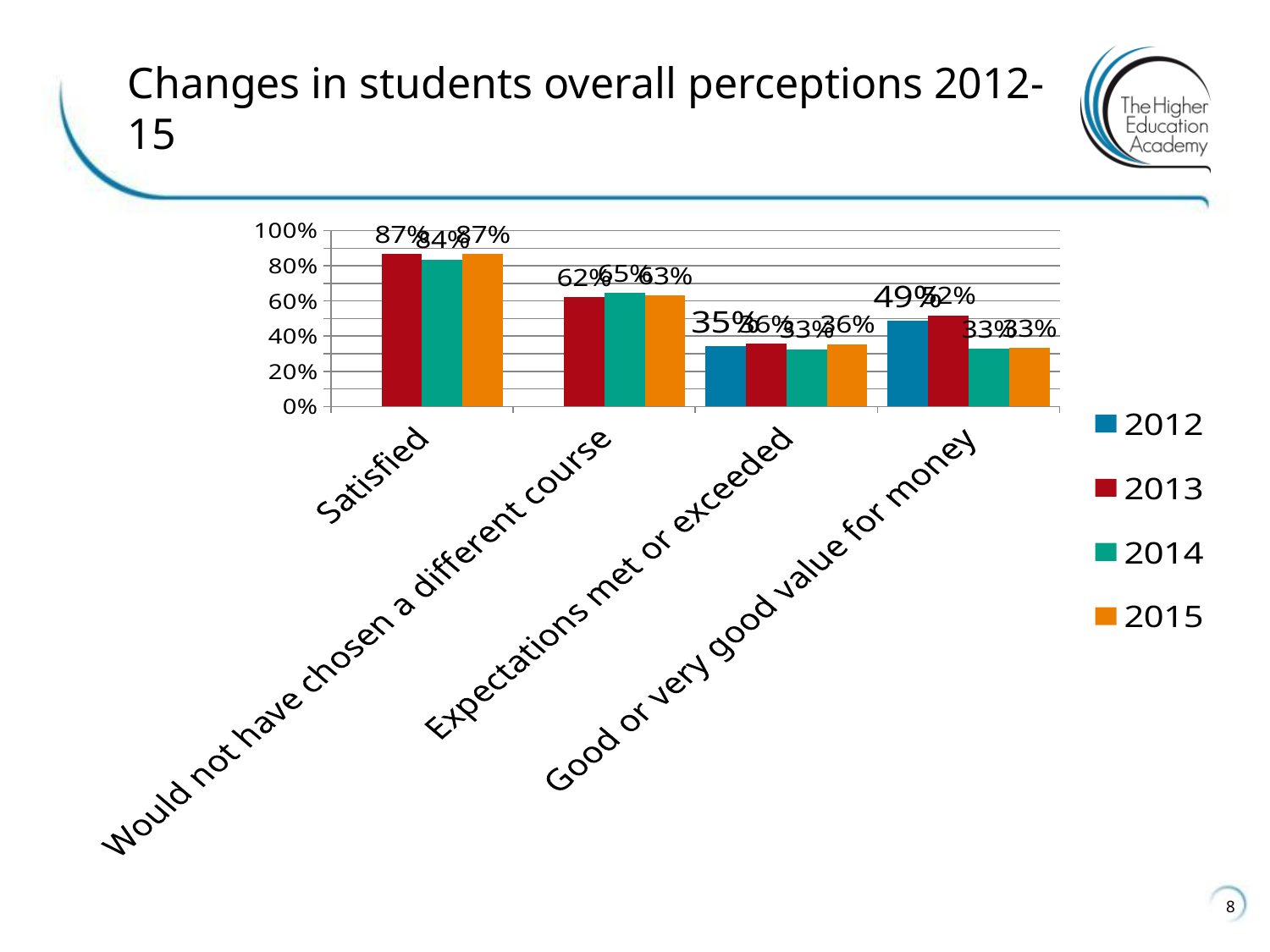
What is the value for 2014 in the 'Would not have chosen a different course' category? 65% In the 'Would not have chosen a different course' category, which is larger: the 2014 value or the 2015 value? 2014 What is the value for 2015 in the 'Good or very good value for money' category? 33% What is the value for 2014 in the Satisfied category? 84% What is the value for 2012 in the 'Expectations met or exceeded' category? 35% Which category has the lowest value for 2012? Expectations met or exceeded Is the 2013 value for 'Good or very good value for money' greater or less than 40%? greater How many series does the legend list? 4 What is the value for 2012 in the 'Good or very good value for money' category? 49% Which category has the highest value for 2015? Satisfied What is the difference between the 2013 and 2014 values in the Satisfied category? 3 percentage points What kind of chart is shown on the slide? Bar chart